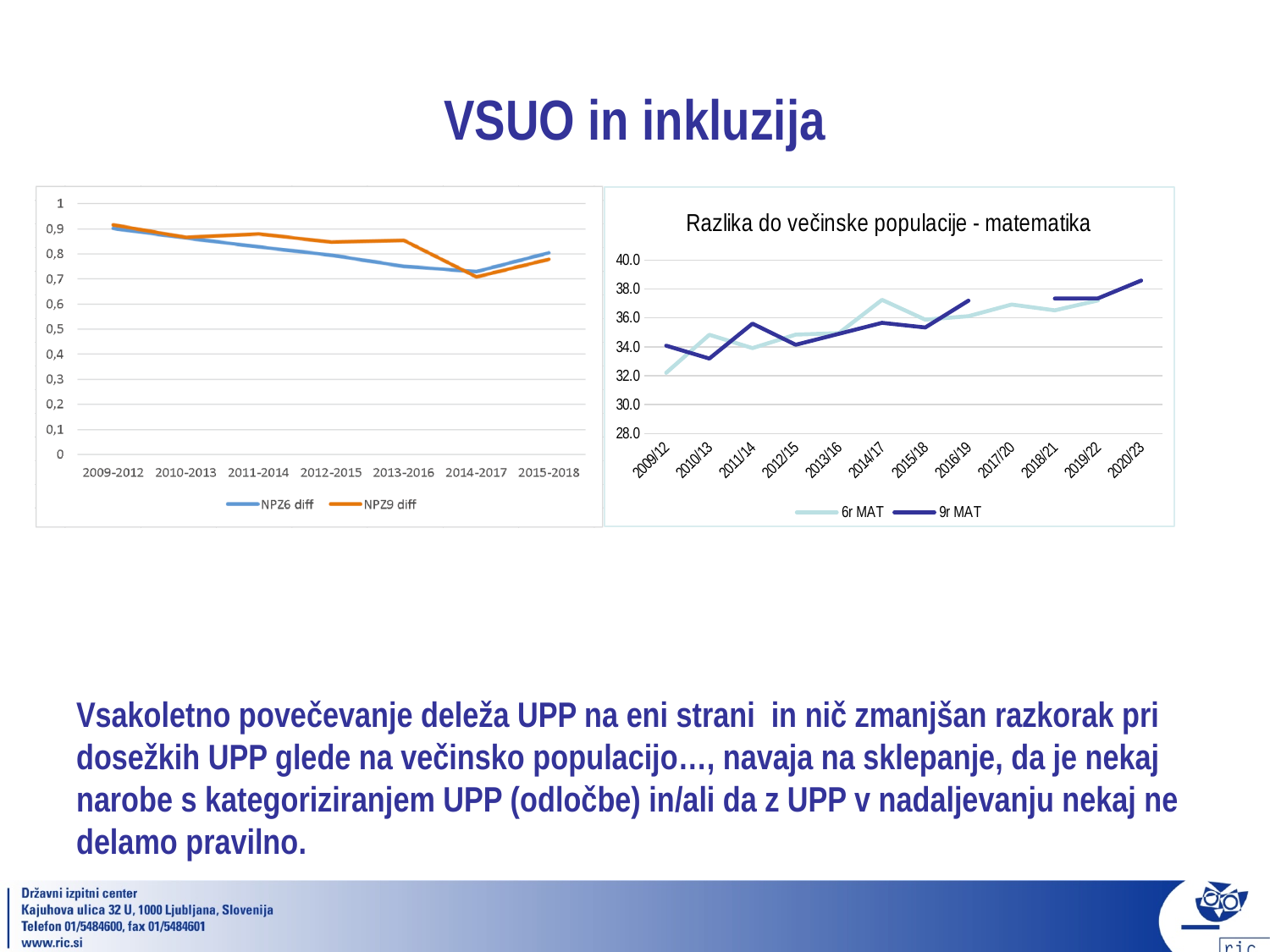
In the chart titled 'Razlika do večinske populacije - matematika', does the 9r MAT series overall rise or fall from 2009/12 to 2020/23? rise In the left chart, is the value of NPZ6 diff for 2009-2012 greater or less than 0.8? greater In the chart titled 'Razlika do večinske populacije - matematika', is the value of 9r MAT for 2020/23 greater or less than 38.0? greater What is the title of the right chart? Razlika do večinske populacije - matematika In the left chart, which series has the larger value for 2013-2016, NPZ6 diff or NPZ9 diff? NPZ9 diff In the left chart, in which period is NPZ9 diff at its lowest? 2014-2017 How many series does the legend of the left chart list? 2 How many periods are shown on the x axis of the left chart? 7 How many periods are shown on the x axis of the chart titled 'Razlika do večinske populacije - matematika'? 12 In the left chart, is the value of NPZ9 diff for 2014-2017 greater or less than 0.8? less What type of chart is the left chart on the slide? line chart In the chart titled 'Razlika do večinske populacije - matematika', in which period is 6r MAT at its lowest? 2009/12